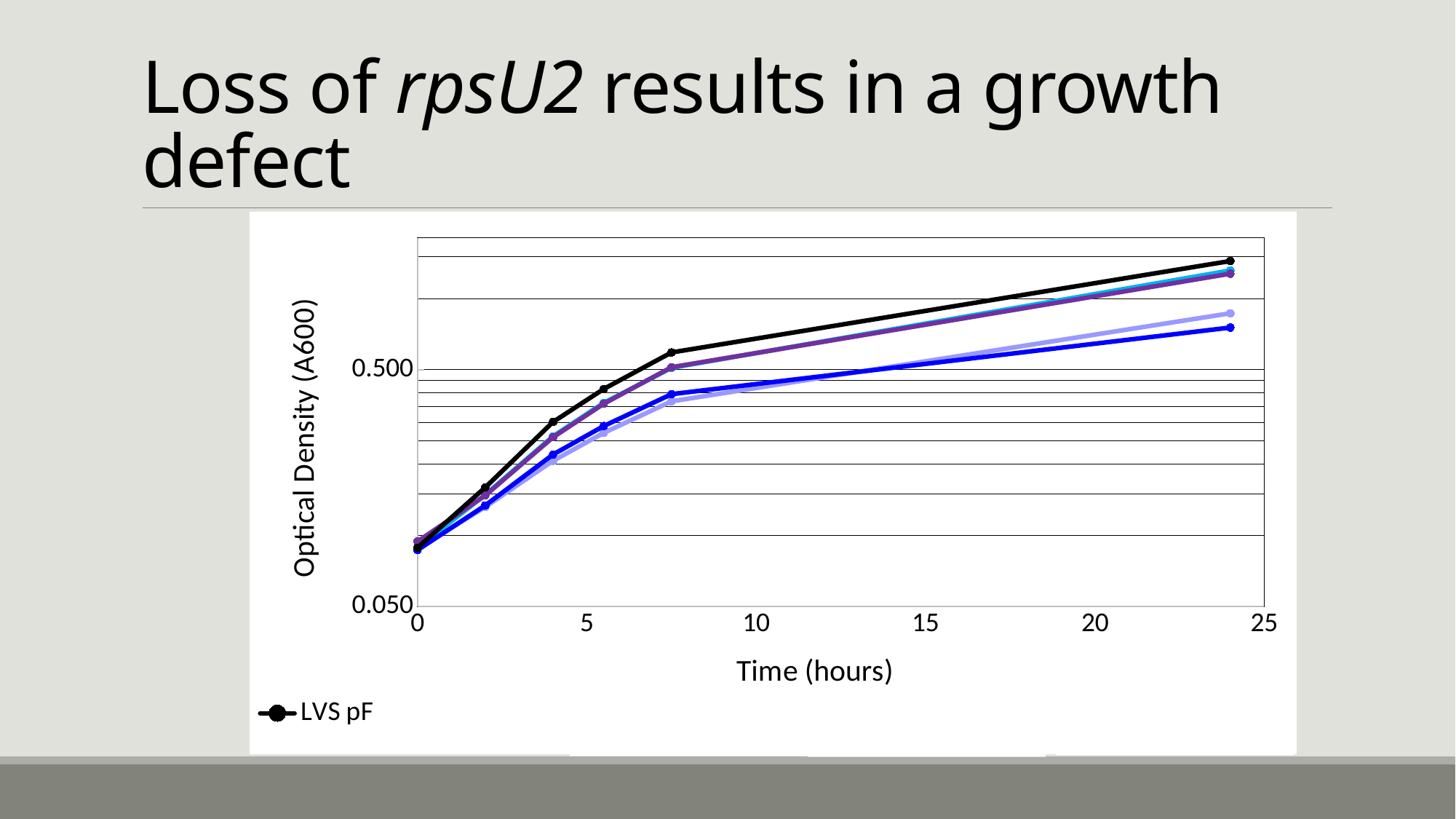
Is the LVS pF value at about 5.5 hours greater or less than 0.500? less What is the label of the y axis of the chart? Optical Density (A600) What kind of chart is shown on the slide? line chart Is the LVS pF value at 0 hours greater or less than 0.050? greater Is the LVS pF value at 0 hours greater or less than 0.500? less How many lines are plotted on the chart? 5 What is the label of the x axis of the chart? Time (hours) How many data points does the LVS pF series have? 6 Which series has the highest value at 24 hours? LVS pF Is the LVS pF value at 24 hours larger or smaller than its value at 0 hours? larger Does the LVS pF series rise or fall as time increases? rise